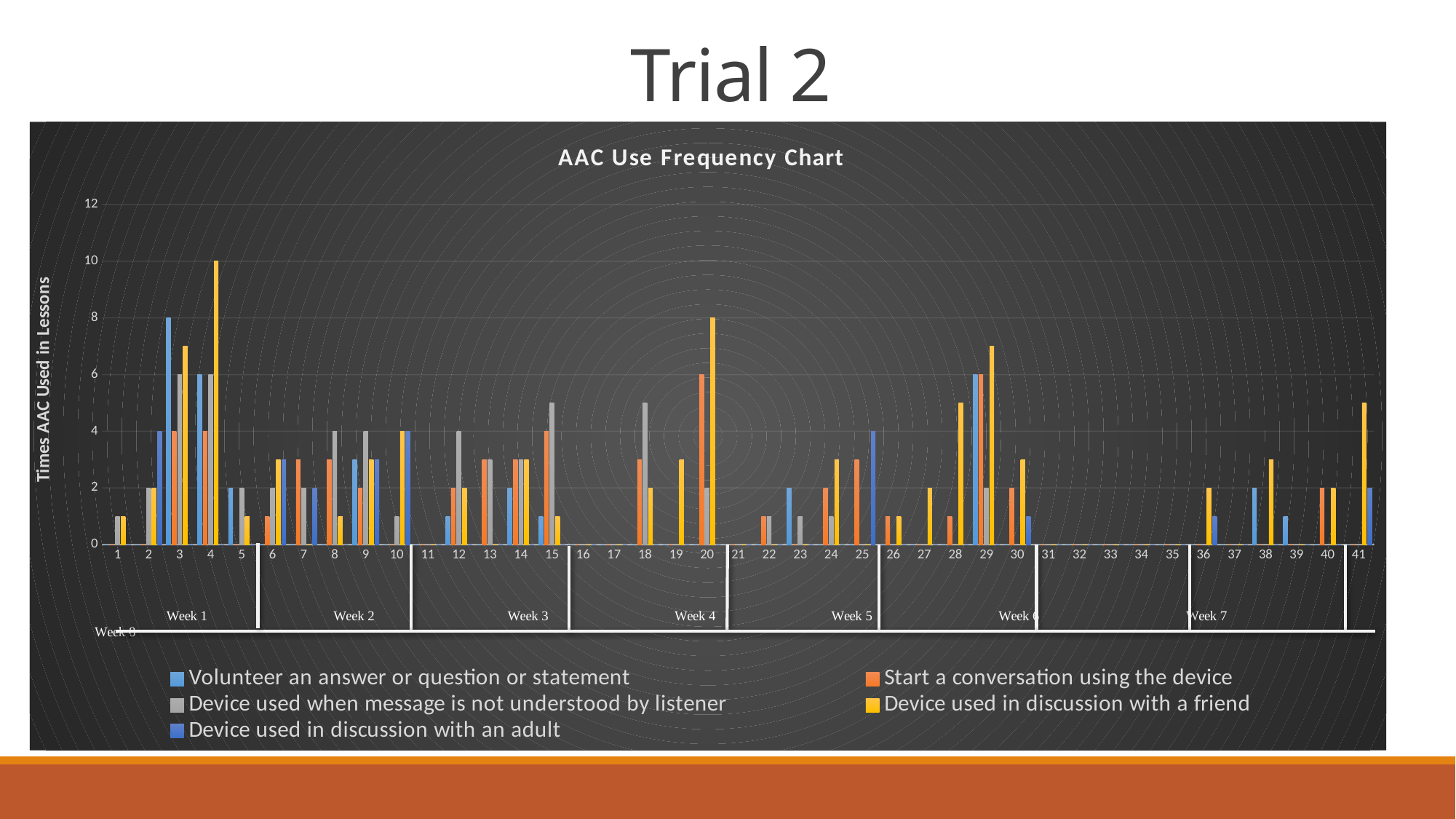
How many series does the legend list? 5 What is the value of 'Volunteer an answer or question or statement' at lesson 3? 8 What is the title of the chart? AAC Use Frequency Chart How many lesson categories are shown along the x axis? 41 What is the value of 'Device used in discussion with a friend' at lesson 20? 8 Is the value for 'Device used in discussion with a friend' at lesson 29 greater or less than 6? greater Is the value for 'Device used in discussion with a friend' at lesson 28 greater or less than 4? greater What kind of chart is shown on the slide? bar chart Which lesson has the highest bar in the whole chart? 4 What is the label on the y axis? Times AAC Used in Lessons What is the value of 'Device used in discussion with a friend' at lesson 4? 10 Which is larger: 'Device used in discussion with a friend' at lesson 4 or at lesson 20? lesson 4